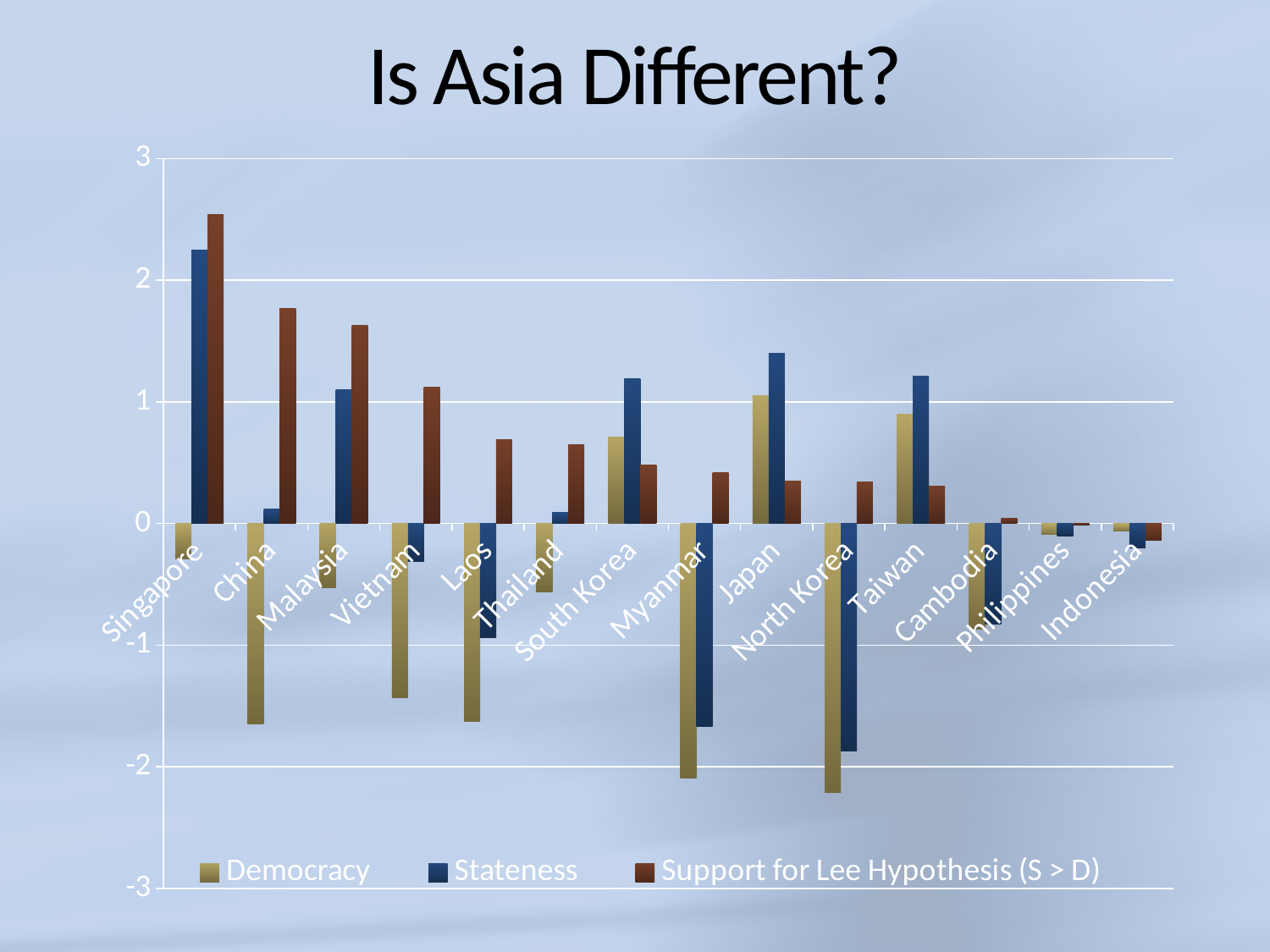
Is the Democracy value for China greater or less than -1? less Which has the larger Stateness value, Singapore or China? Singapore What is the title of the chart on the slide? Is Asia Different? Which country has the highest Stateness value? Singapore Which country has the highest value for Support for Lee Hypothesis (S > D)? Singapore How many series does the chart's legend list? 3 Which series is shown in the legend after Democracy and Stateness? Support for Lee Hypothesis (S > D) How many countries are shown on the x axis of the chart? 14 Is the Support for Lee Hypothesis (S > D) value for Singapore greater or less than 2? greater Is the Democracy value for North Korea greater or less than -2? less What kind of chart is shown on the slide? bar chart